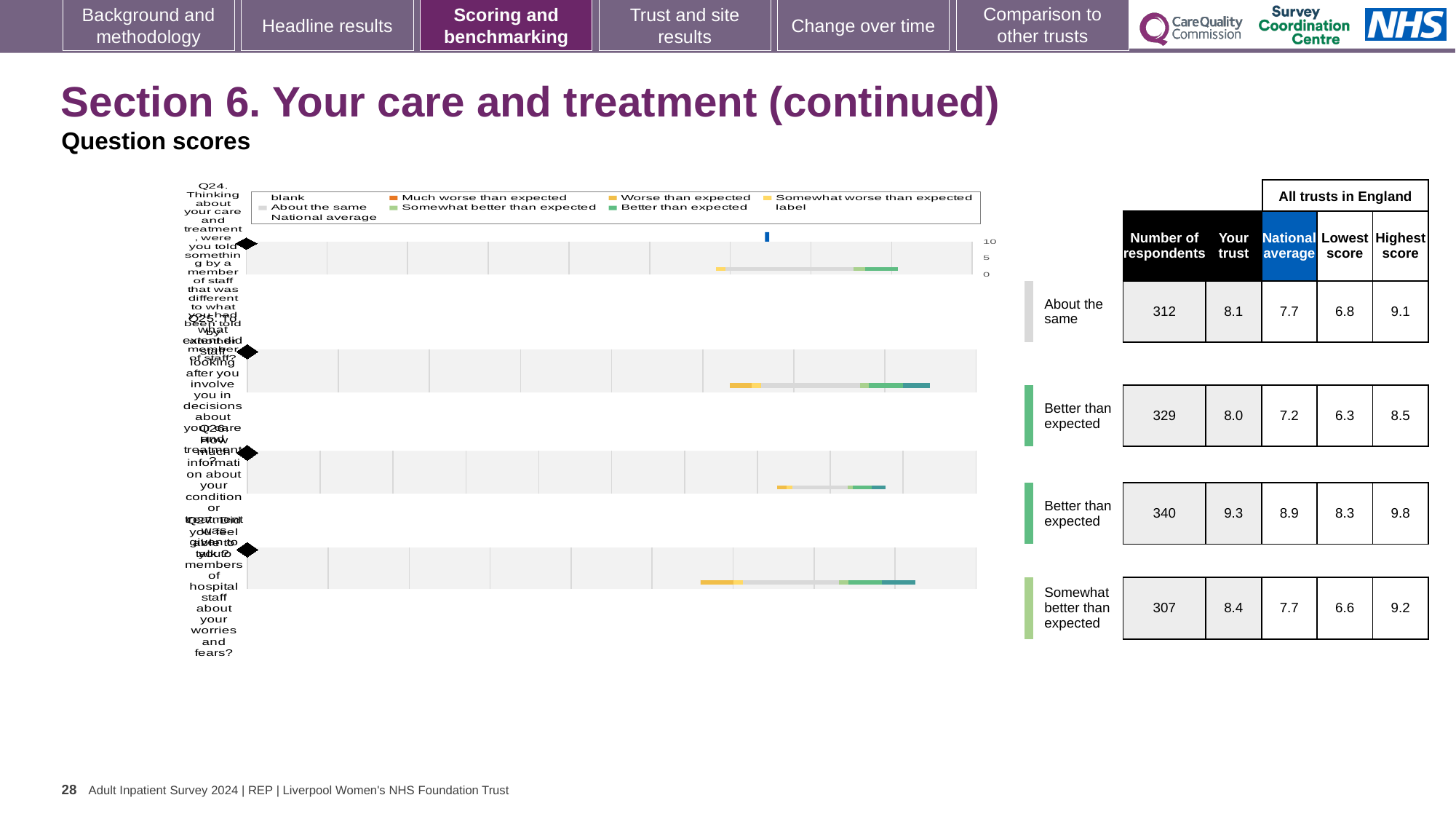
In the table beside the chart, what is the national average for Q26? 8.9 How many questions (rows) are plotted in the question scores chart? 4 In the table beside the chart, what is the highest score across all trusts in England for Q27? 9.2 What benchmark category is shown for Q26 next to the chart? Better than expected What is the difference between the 'Your trust' score and the national average for Q26? 0.4 In the table beside the chart, how many respondents answered Q25? 329 Which question has the lowest number of respondents in the table beside the chart? Q27 What kind of chart is used to show the question scores on this slide? bar chart Which is larger: the 'Your trust' score for Q24 or for Q25? Q24 What benchmark category is shown for Q24 next to the chart? About the same Which question has the highest 'Your trust' score in the table beside the chart? Q26 In the table beside the chart, what is the 'Your trust' score for Q24? 8.1